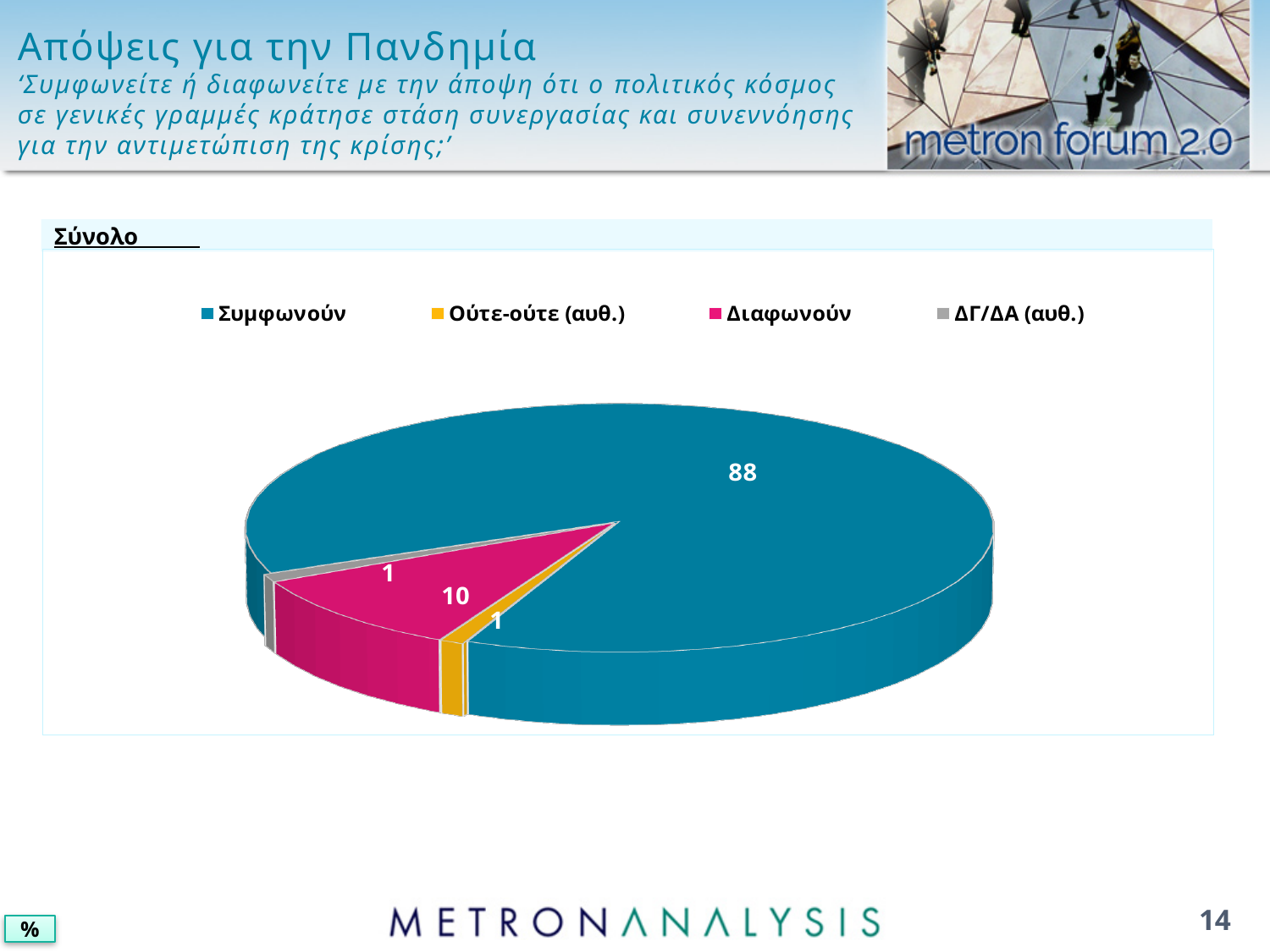
What colour is the slice for Διαφωνούν? magenta What kind of chart is shown on the slide? pie chart What is the value for ΔΓ/ΔΑ (αυθ.)? 1 What is the heading printed above the chart? Σύνολο What is the value for Συμφωνούν? 88 How many slices does the pie chart have? 4 What is the value for Διαφωνούν? 10 What is the value for Ούτε-ούτε (αυθ.)? 1 Which is larger, the value for Διαφωνούν or the value for Ούτε-ούτε (αυθ.)? Διαφωνούν How many categories does the legend list? 4 What is the difference between the values for Συμφωνούν and Διαφωνούν? 78 Which category has the largest slice of the pie? Συμφωνούν